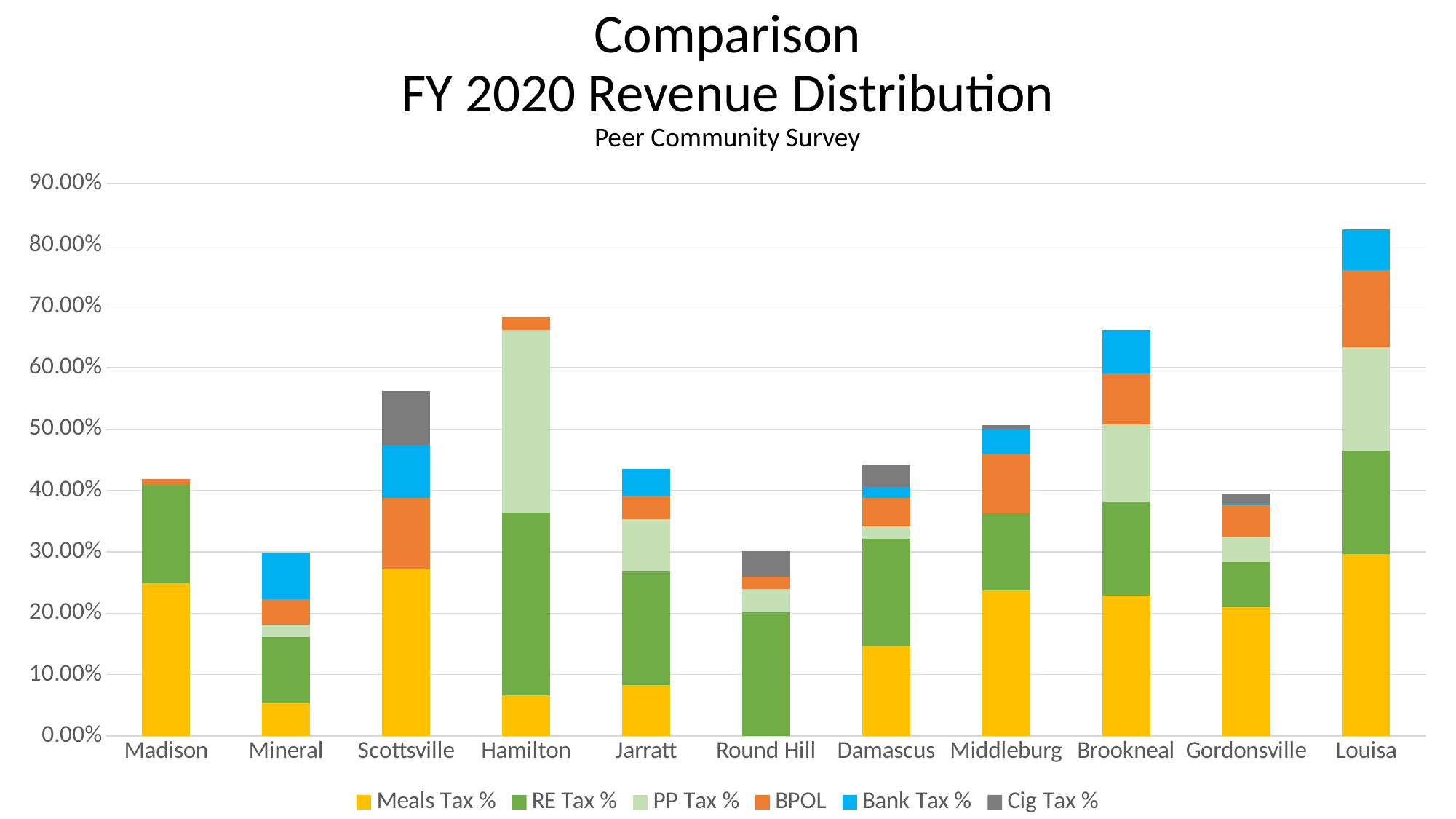
Which has the larger total stacked bar, Hamilton or Jarratt? Hamilton Is the total stacked value for Scottsville greater or less than 60.00%? less Which series is shown in grey in the legend? Cig Tax % Which community has the tallest stacked bar overall? Louisa What is the subtitle shown below the main chart title? Peer Community Survey Is the total stacked value for Louisa greater or less than 80.00%? greater How many series does the legend list? 6 Is the total stacked value for Madison greater or less than 30.00%? greater Which has the larger total stacked bar, Brookneal or Middleburg? Brookneal How many communities are shown on the x axis of the chart? 11 What kind of chart is shown on the slide? Stacked bar chart